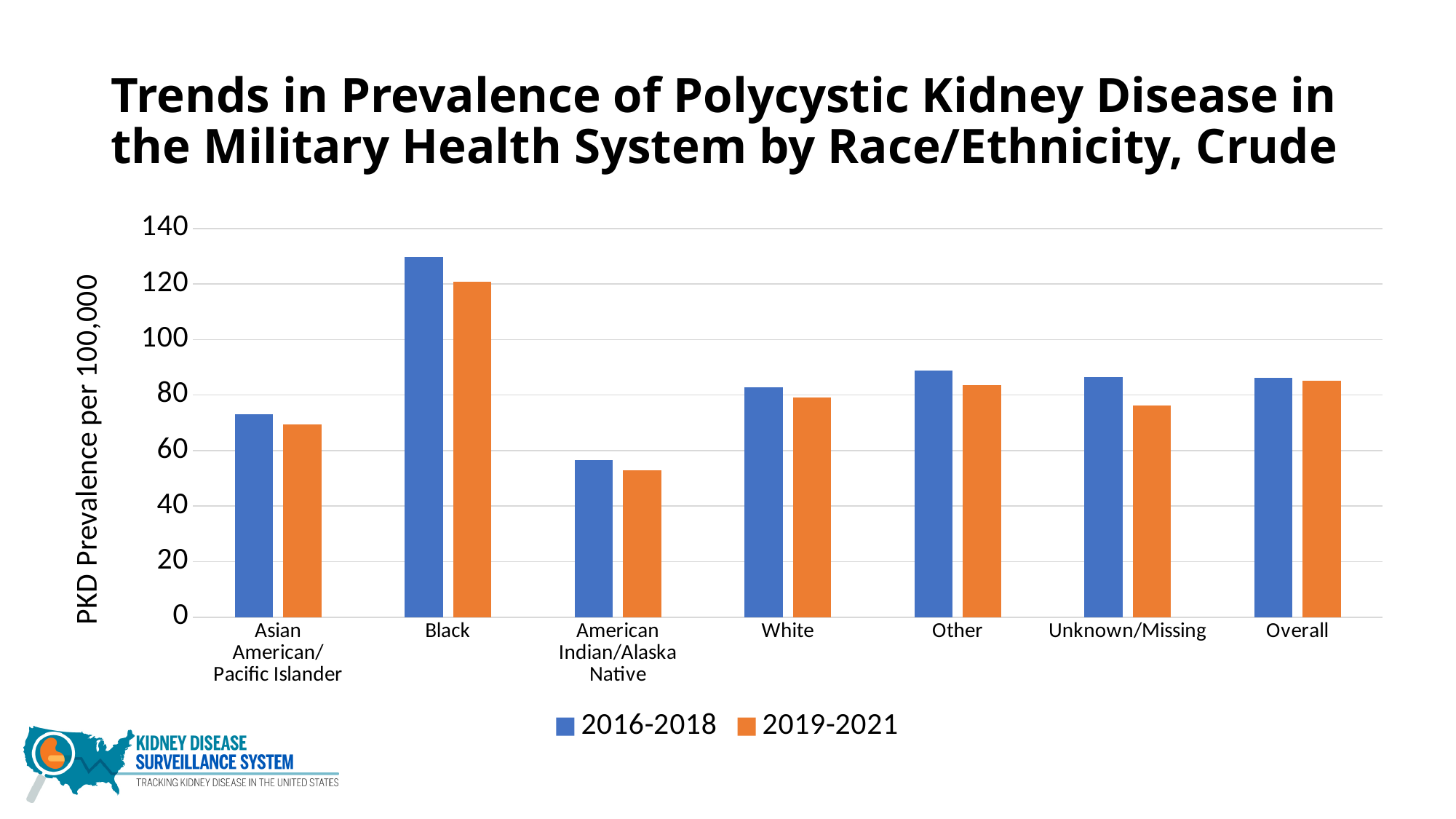
For Unknown/Missing, which period has the larger value, 2016-2018 or 2019-2021? 2016-2018 Which colour represents the 2019-2021 series in the legend? Orange Is the 2016-2018 value for Other greater or less than 80? greater Is the 2016-2018 value for Asian American/Pacific Islander greater or less than 60? greater For Black, is the 2019-2021 value higher or lower than the 2016-2018 value? lower Is the 2019-2021 value for American Indian/Alaska Native greater or less than 60? less How many race/ethnicity categories are shown on the x axis? 7 How many series does the legend list? 2 What kind of chart is shown on the slide? Bar chart Which category has the lowest PKD prevalence for 2019-2021? American Indian/Alaska Native Which category has the highest PKD prevalence for 2016-2018? Black